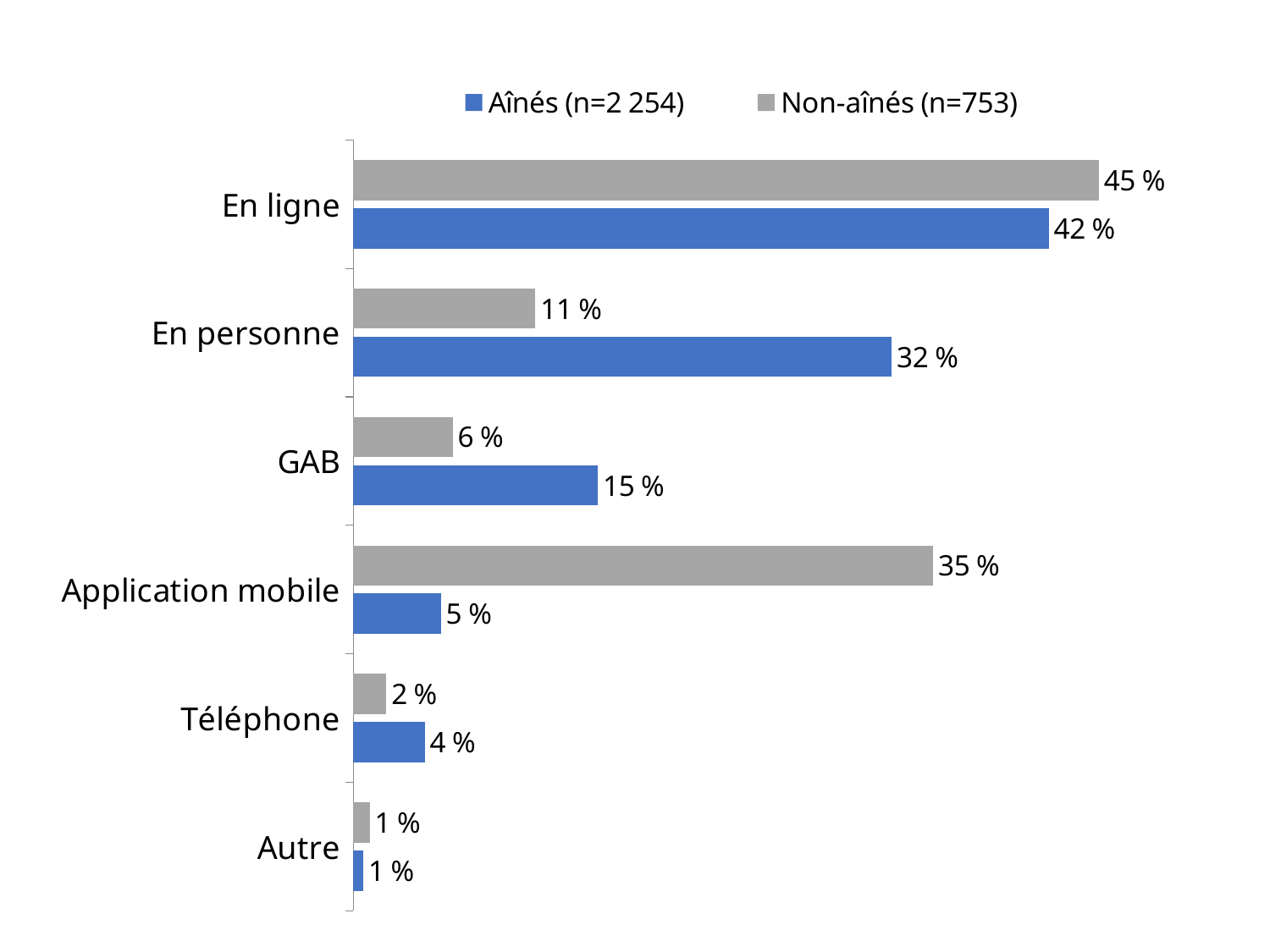
Which is larger for Téléphone: the Aînés (n=2 254) value or the Non-aînés (n=753) value? Aînés (n=2 254) Which category has the lowest value for Aînés (n=2 254)? Autre What is the value for Aînés (n=2 254) in the En ligne category? 42 % What is the value for Non-aînés (n=753) in the En personne category? 11 % How many series does the legend list? 2 What is the value for Aînés (n=2 254) in the GAB category? 15 % What is the difference between the Non-aînés (n=753) and Aînés (n=2 254) values for Application mobile? 30 % What is the difference between the Aînés (n=2 254) and Non-aînés (n=753) values for En personne? 21 % What kind of chart is shown on the slide? Bar chart What is the value for Non-aînés (n=753) in the Application mobile category? 35 % Which category has the highest value for Non-aînés (n=753)? En ligne How many categories are shown on the chart? 6